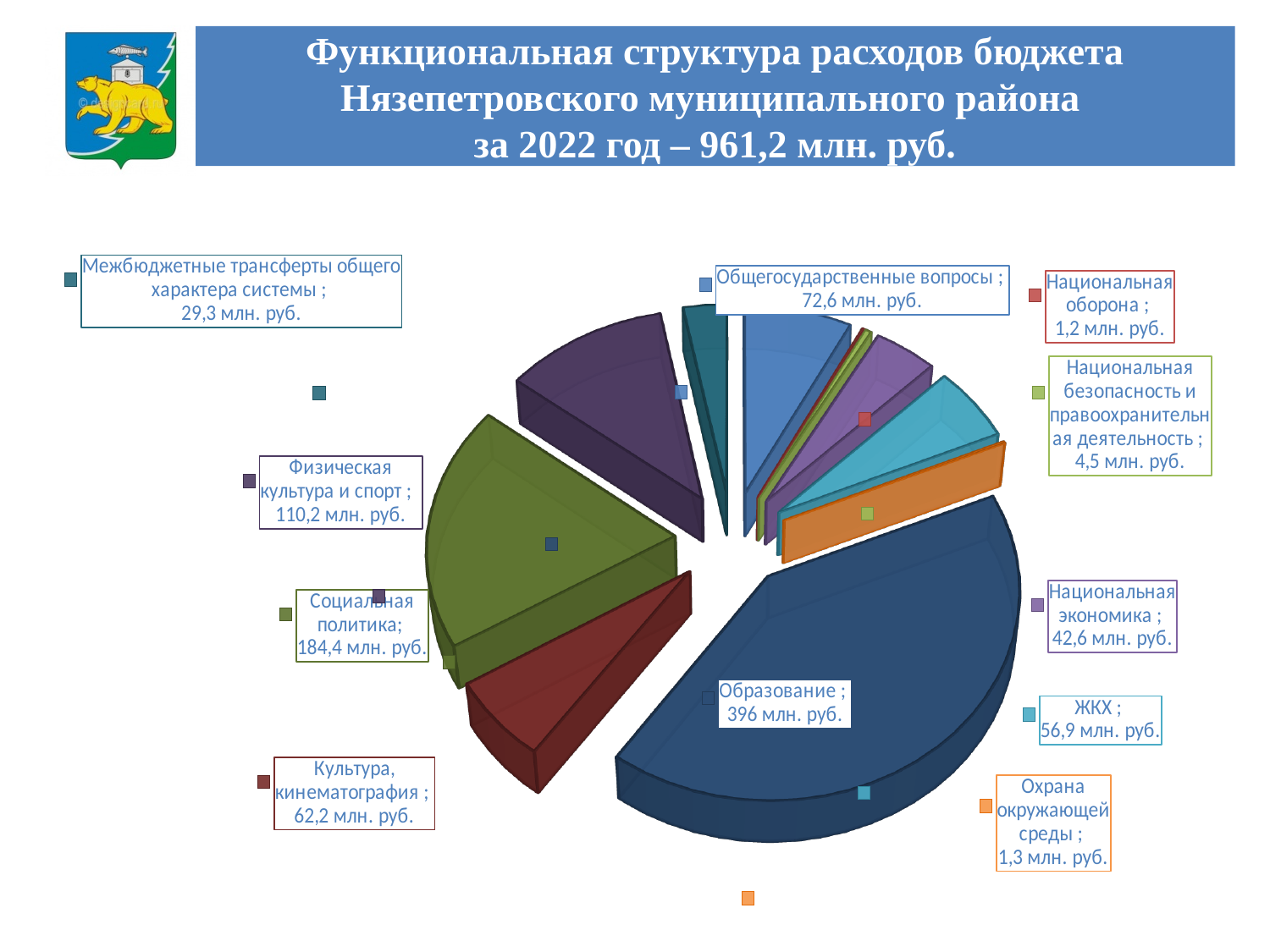
How many categories (slices) does the pie chart show? 11 What is the difference between Социальная политика and Физическая культура и спорт? 74,2 млн. руб. What type of chart is shown on the slide? Pie chart What is the value for Образование? 396 млн. руб. Which category has the largest value? Образование Which category has the smallest value? Национальная оборона What is the value for ЖКХ? 56,9 млн. руб. Which is larger: Культура, кинематография or Национальная экономика? Культура, кинематография What is the value for Национальная безопасность и правоохранительная деятельность? 4,5 млн. руб. What is the value for Социальная политика? 184,4 млн. руб. What total budget expenditure for 2022 is stated in the chart title? 961,2 млн. руб. What is the difference between Общегосударственные вопросы and ЖКХ? 15,7 млн. руб.